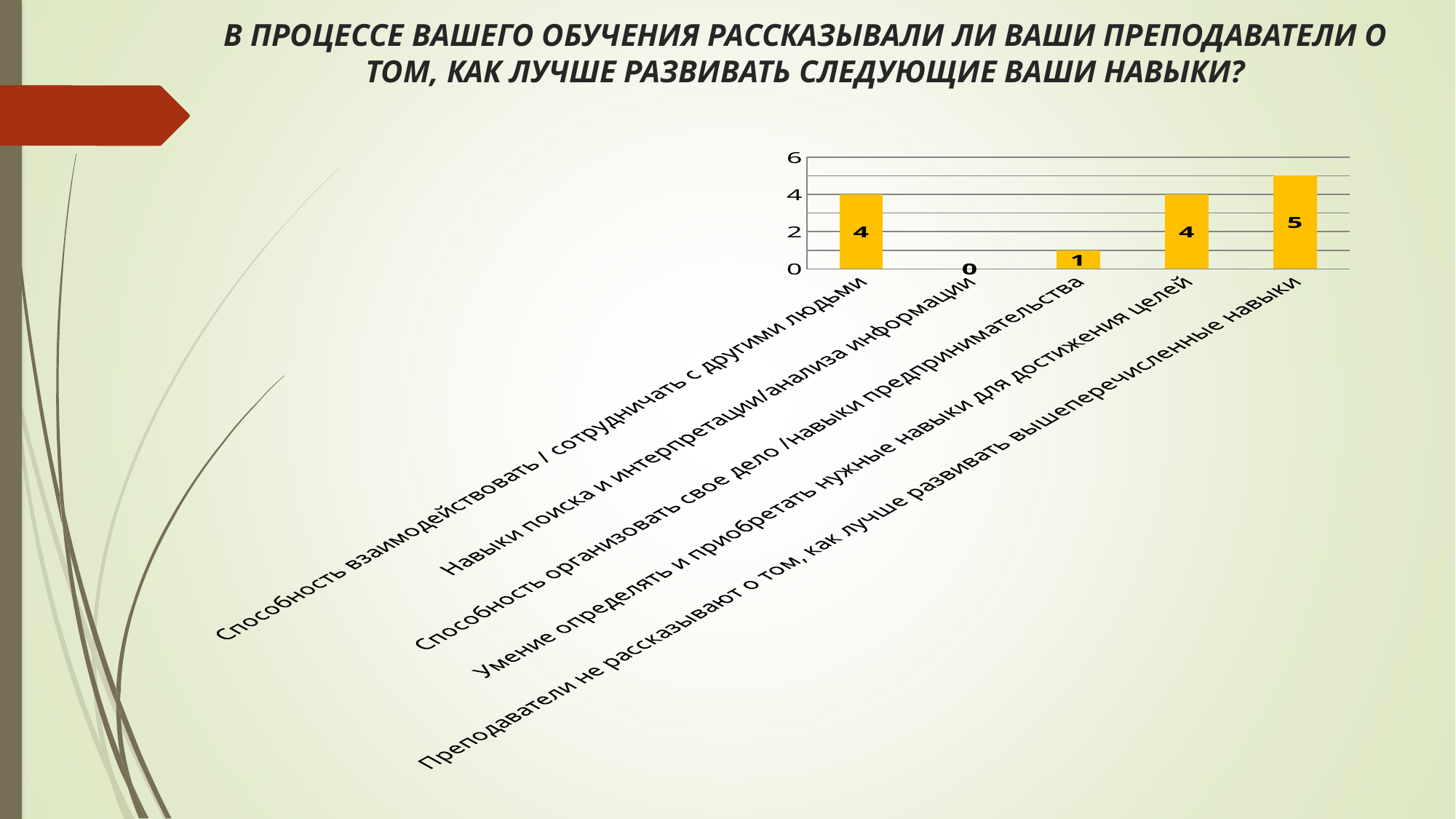
What is the value for "Способность взаимодействовать / сотрудничать с другими людьми"? 4 Which category has the lowest value? Навыки поиска и интерпретации/анализа информации What is the value for "Навыки поиска и интерпретации/анализа информации"? 0 What is the value for "Преподаватели не рассказывают о том, как лучше развивать вышеперечисленные навыки"? 5 What is the difference between the value for "Преподаватели не рассказывают о том, как лучше развивать вышеперечисленные навыки" and the value for "Способность организовать свое дело /навыки предпринимательства"? 4 Which category has the highest value? Преподаватели не рассказывают о том, как лучше развивать вышеперечисленные навыки What kind of chart is shown on the slide? bar chart How many categories are shown on the x axis of the chart? 5 What is the value for "Умение определять и приобретать нужные навыки для достижения целей"? 4 What is the maximum value shown on the vertical axis of the chart? 6 What is the value for "Способность организовать свое дело /навыки предпринимательства"? 1 Which is larger: the value for "Способность взаимодействовать / сотрудничать с другими людьми" or the value for "Способность организовать свое дело /навыки предпринимательства"? Способность взаимодействовать / сотрудничать с другими людьми